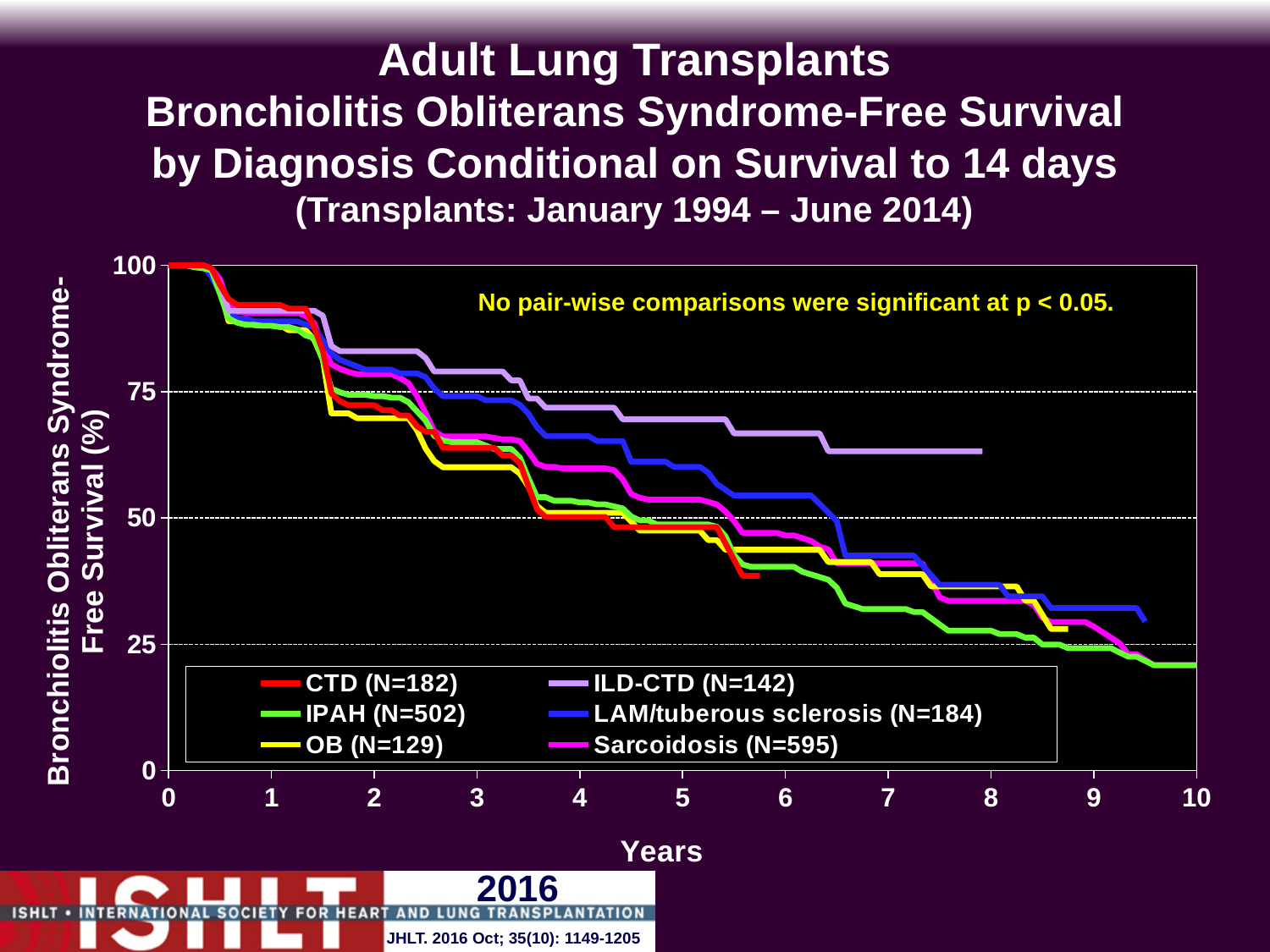
Is the BOS-free survival for OB at 3 years greater or less than 75%? less Is the BOS-free survival for ILD-CTD at 7 years greater or less than 50%? greater How many diagnosis groups does the legend list? 6 Which diagnosis group has the lowest BOS-free survival at 7 years? IPAH At 7 years, which has higher BOS-free survival: ILD-CTD or IPAH? ILD-CTD Which diagnosis group has the highest BOS-free survival at 7 years? ILD-CTD What is the label of the x axis? Years What kind of chart is shown on the slide? Line chart Do the survival curves rise or fall as the years increase? Fall Is the BOS-free survival for IPAH at 10 years greater or less than 25%? less What is the N for the Sarcoidosis group in the legend? 595